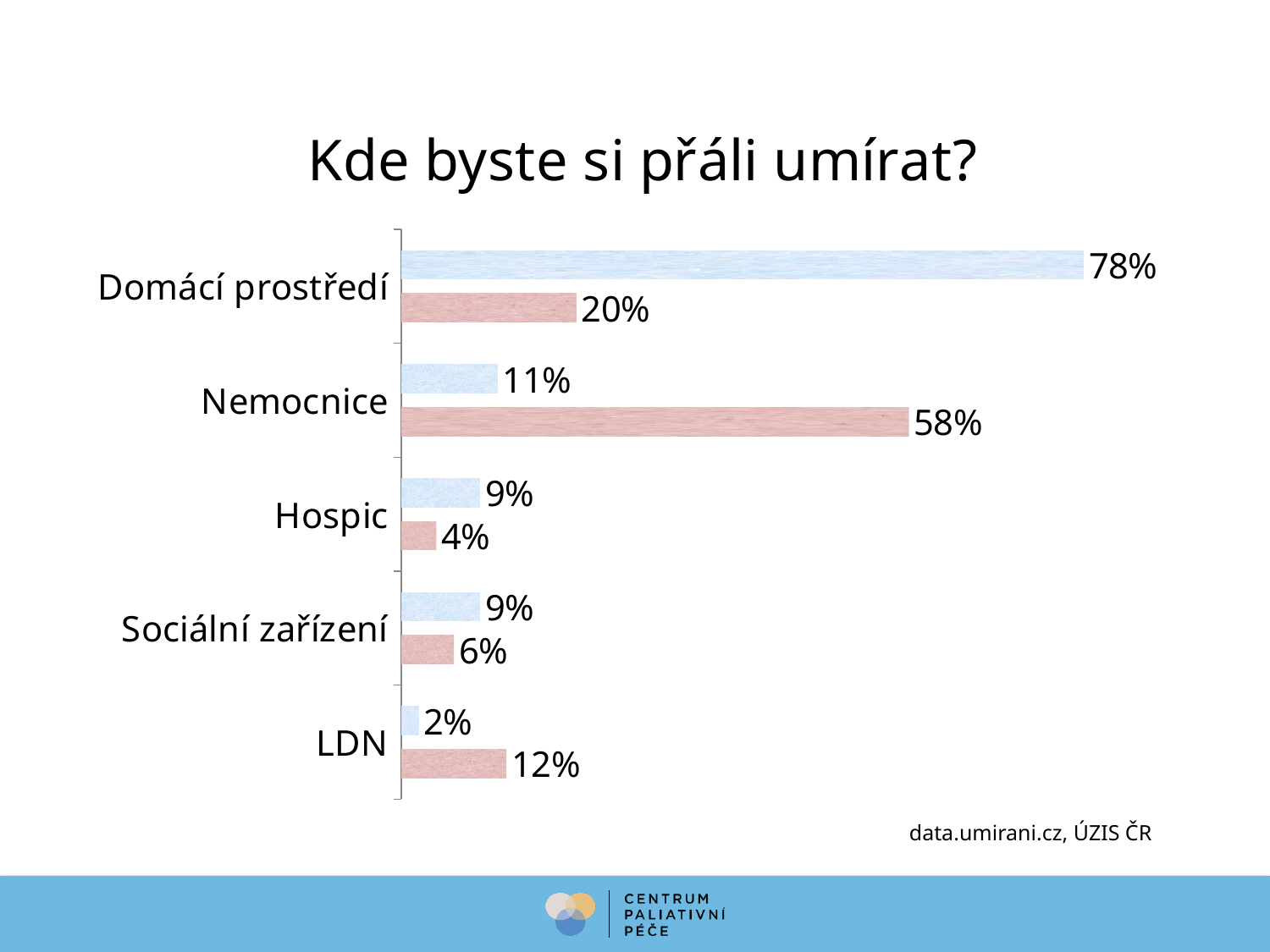
Which category has the highest blue bar? Domácí prostředí What is the title of the chart? Kde byste si přáli umírat? What is the value of the blue bar for Domácí prostředí? 78% What is the difference between the blue and pink bars for Domácí prostředí? 58% How many categories are shown on the chart? 5 What kind of chart is shown on the slide? bar chart What is the value of the pink bar for Nemocnice? 58% What is the value of the pink bar for Hospic? 4% What is the difference between the pink and blue bars for Nemocnice? 47% What is the value of the blue bar for LDN? 2% Which category has the lowest pink bar? Hospic For LDN, which bar is larger, the blue or the pink one? pink